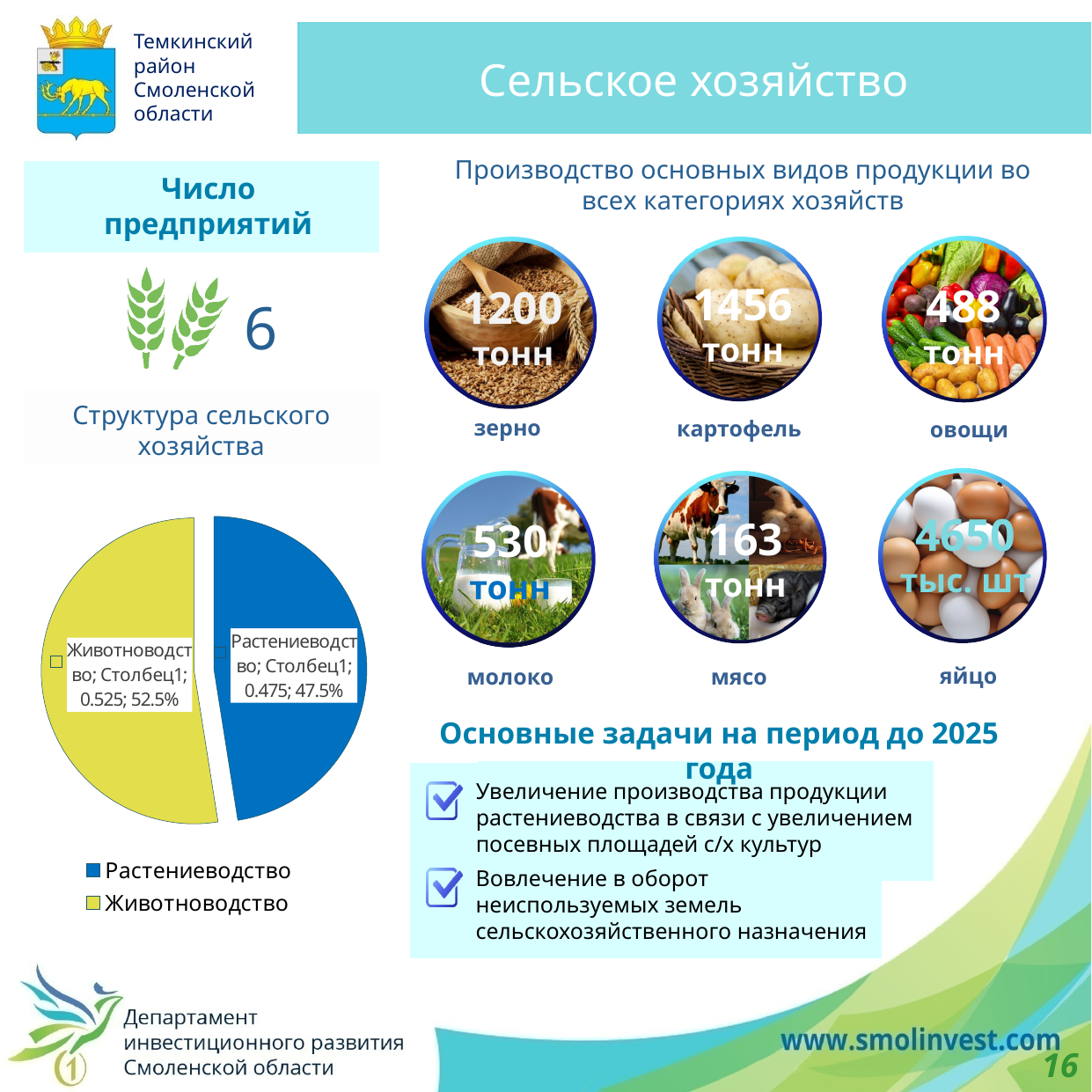
In the pie chart "Структура сельского хозяйства", what percentage share does Растениеводство have? 47.5% In the pie chart "Структура сельского хозяйства", what colour is the Растениеводство slice? blue In the pie chart "Структура сельского хозяйства", which slice is the largest? Животноводство In the pie chart "Структура сельского хозяйства", by how many percentage points does Животноводство exceed Растениеводство? 5% In the pie chart "Структура сельского хозяйства", which is larger: Растениеводство or Животноводство? Животноводство In the pie chart "Структура сельского хозяйства", which slice is the smallest? Растениеводство How many entries does the legend of the pie chart "Структура сельского хозяйства" list? 2 In the pie chart "Структура сельского хозяйства", what percentage share does Животноводство have? 52.5% How many slices does the pie chart "Структура сельского хозяйства" have? 2 In the pie chart "Структура сельского хозяйства", what decimal value is printed in the data label for Животноводство? 0.525 In the pie chart "Структура сельского хозяйства", what decimal value is printed in the data label for Растениеводство? 0.475 What kind of chart is shown under the heading "Структура сельского хозяйства"? pie chart